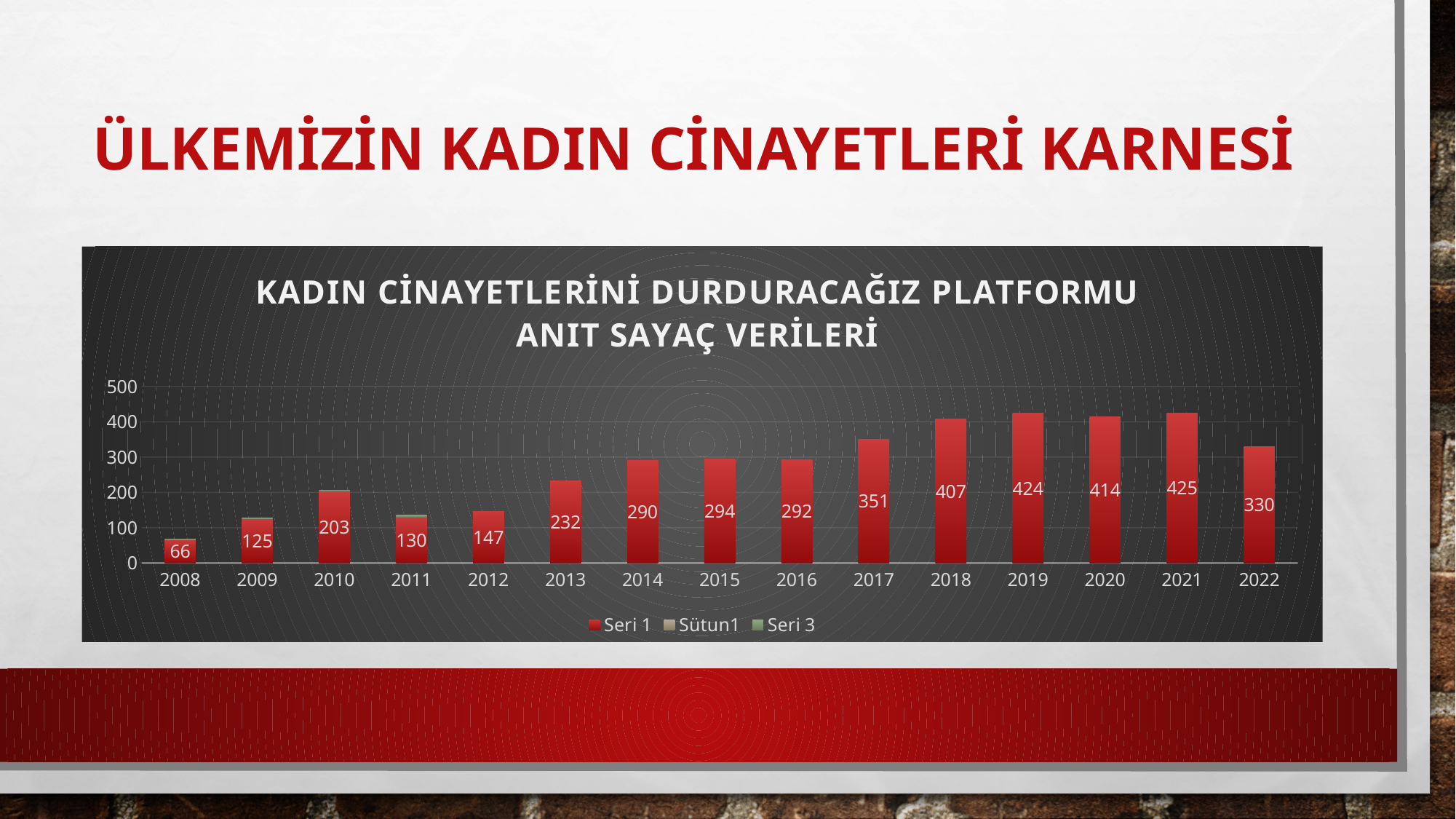
What kind of chart is shown on the slide? bar chart What is the difference between the values for 2018 and 2017? 56 Which year has the lowest value? 2008 How many years are shown on the x axis? 15 What value is shown for 2022? 330 How many series does the legend list? 3 Which year has the highest value? 2021 What value is shown for 2008? 66 What value is shown for 2017? 351 Is the value for 2019 greater or less than 400? greater Which is larger, the value for 2010 or the value for 2011? 2010 What is the difference between the values for 2022 and 2008? 264